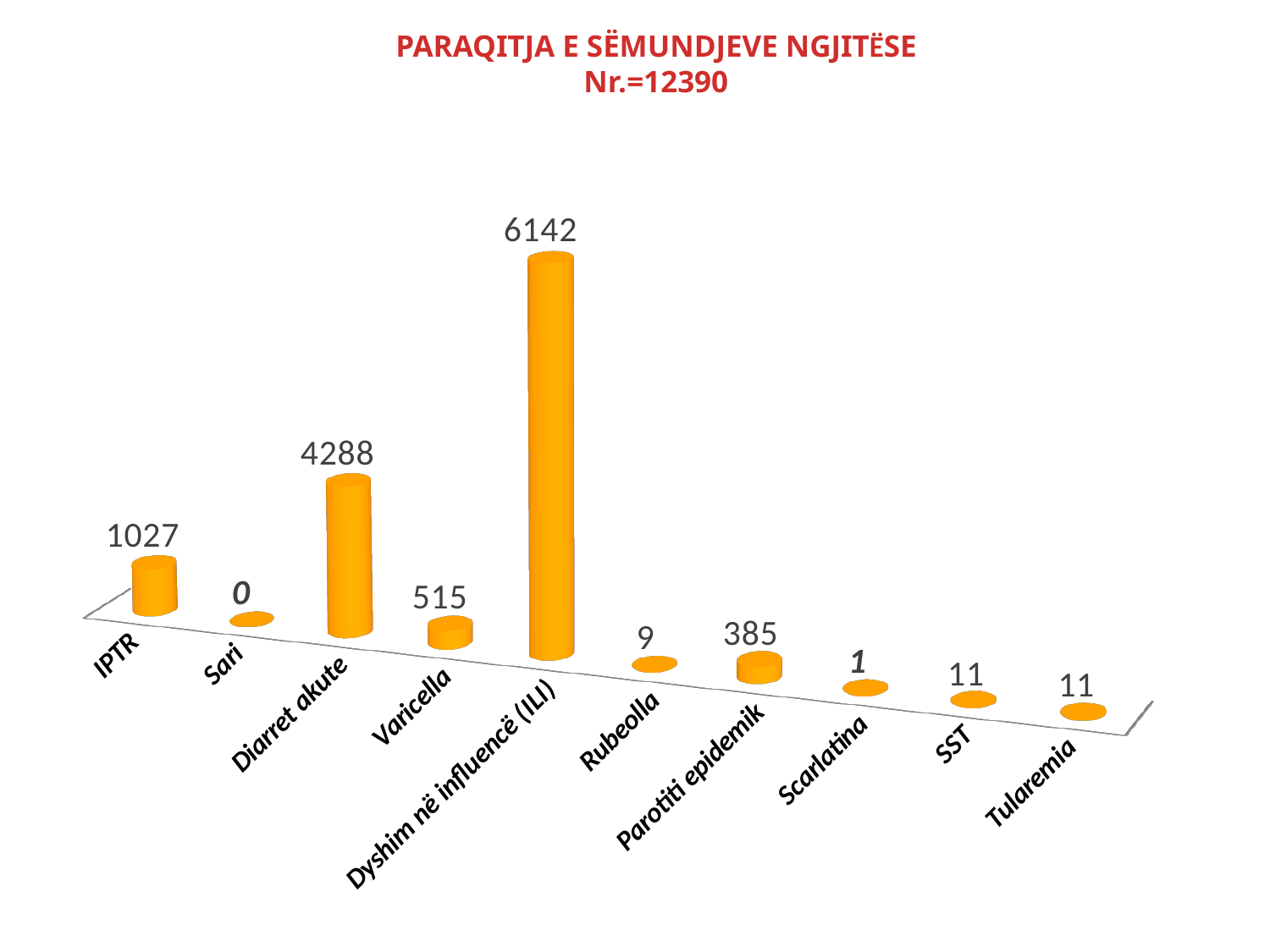
What kind of chart is shown on the slide? Bar chart Which category has the lowest value? Sari What total number (Nr.) is given in the chart title? 12390 Which is larger, the value for Varicella or the value for Parotiti epidemik? Varicella What is the difference between the values for IPTR and Varicella? 512 Which category has the highest value? Dyshim në influencë (ILI) What is the value for Diarret akute? 4288 What is the difference between the values for Dyshim në influencë (ILI) and Diarret akute? 1854 What is the value for Parotiti epidemik? 385 How many categories are shown on the chart? 10 What is the value for Dyshim në influencë (ILI)? 6142 What is the value for IPTR? 1027